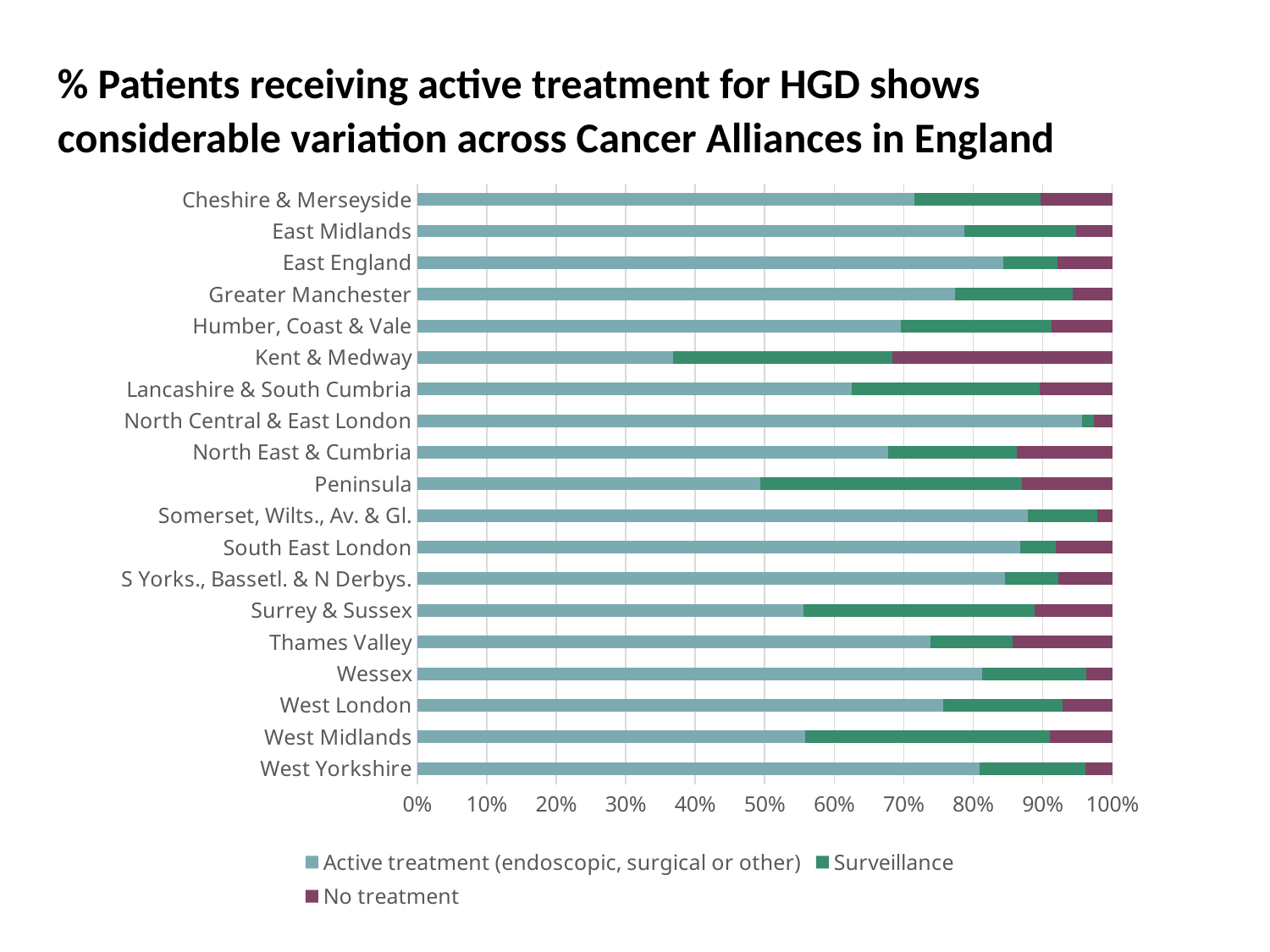
How many series does the legend list? 3 Is the active treatment share for Kent & Medway greater or less than 50%? less What kind of chart is shown on the slide? Stacked bar chart Which Cancer Alliance has the largest 'No treatment' share? Kent & Medway Is the active treatment share for Peninsula greater or less than 60%? less Which has a larger active treatment share, East Midlands or Humber, Coast & Vale? East Midlands How many Cancer Alliances (categories) are plotted on the chart? 19 Which Cancer Alliance has the highest share of patients receiving active treatment? North Central & East London Which Cancer Alliance has the lowest share of patients receiving active treatment? Kent & Medway Is the active treatment share for North Central & East London greater or less than 90%? greater Which series is shown in the darkest (purple) colour in the legend? No treatment